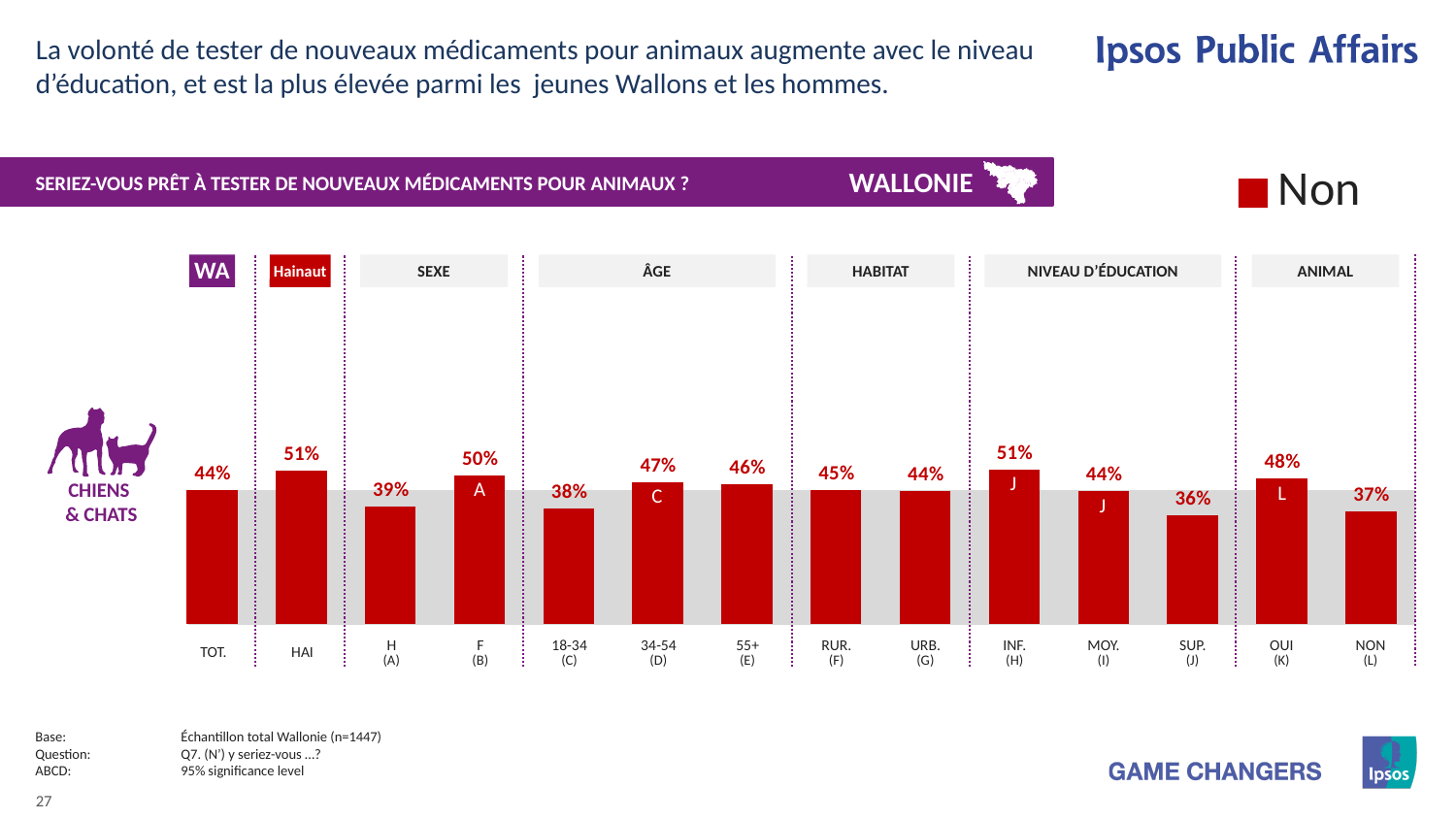
Which is larger, the value for OUI or the value for NON under Animal? OUI What is the value for HAI (Hainaut)? 51% What is the difference between the values for F and H under Sexe? 11% What is the legend entry shown for the red bars? Non What is the value for TOT.? 44% What is the difference between the values for INF. and SUP.? 15% How many series does the legend list? 1 What kind of chart is shown on the slide? Bar chart How many bars are plotted in the chart? 14 What is the value for the 18-34 age group? 38% What is the value for SUP. under Niveau d'éducation? 36% Which category has the lowest value? SUP.